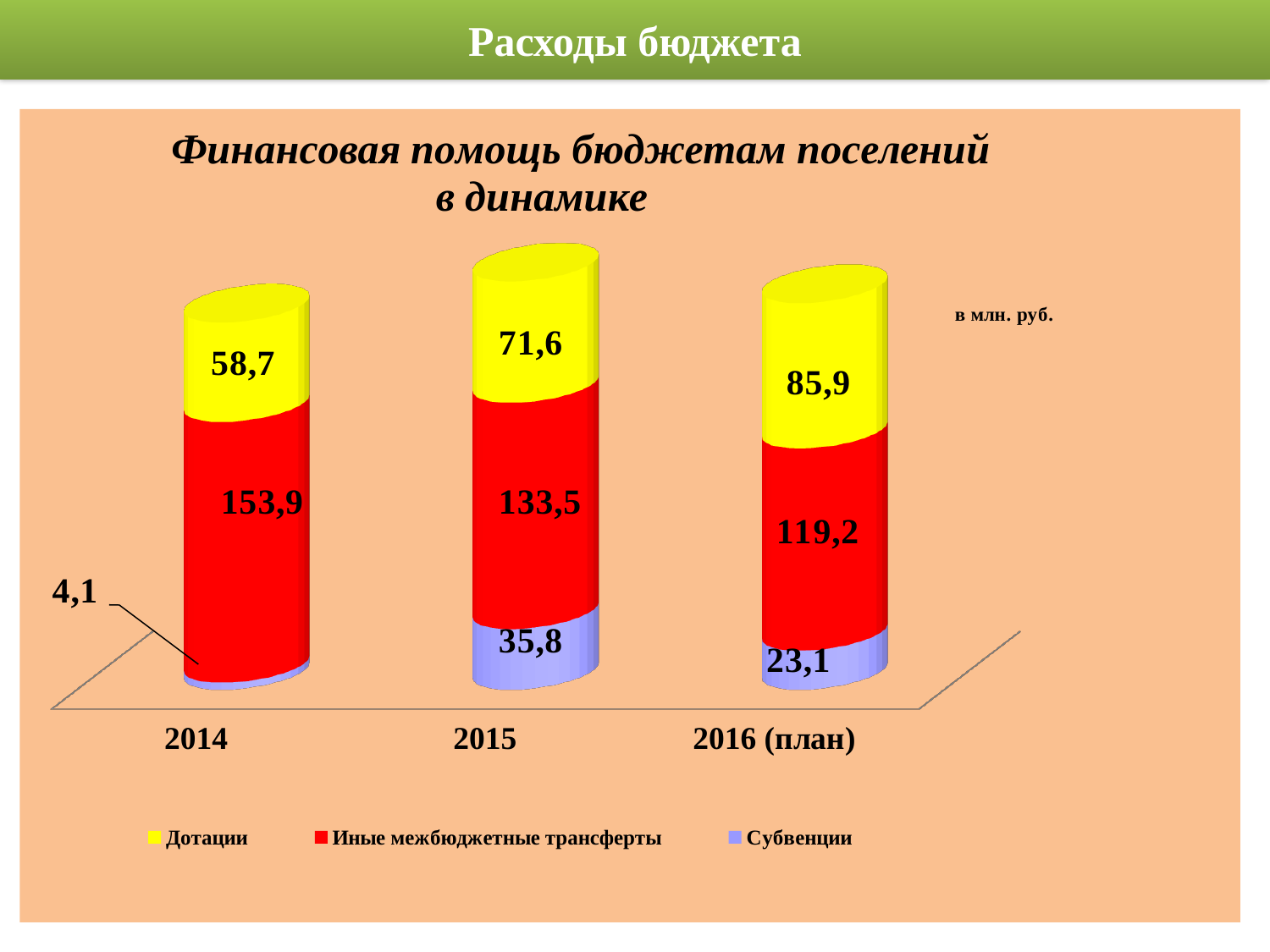
In which year is the value for Дотации highest? 2016 (план) What is the value for Иные межбюджетные трансферты in 2015? 133,5 What kind of chart is shown on the slide? Stacked bar chart Do the values for Иные межбюджетные трансферты rise or fall from 2014 to 2016 (план)? Fall What is the value for Субвенции in 2016 (план)? 23,1 Which is larger: Субвенции in 2015 or Субвенции in 2016 (план)? 2015 How many years (categories) are shown on the x axis? 3 What is the difference between the Иные межбюджетные трансферты values for 2014 and 2016 (план)? 34,7 What is the total of the stacked bar for 2015? 240,9 In which year is the value for Субвенции lowest? 2014 What is the value for Дотации in 2014? 58,7 How many series does the legend list? 3